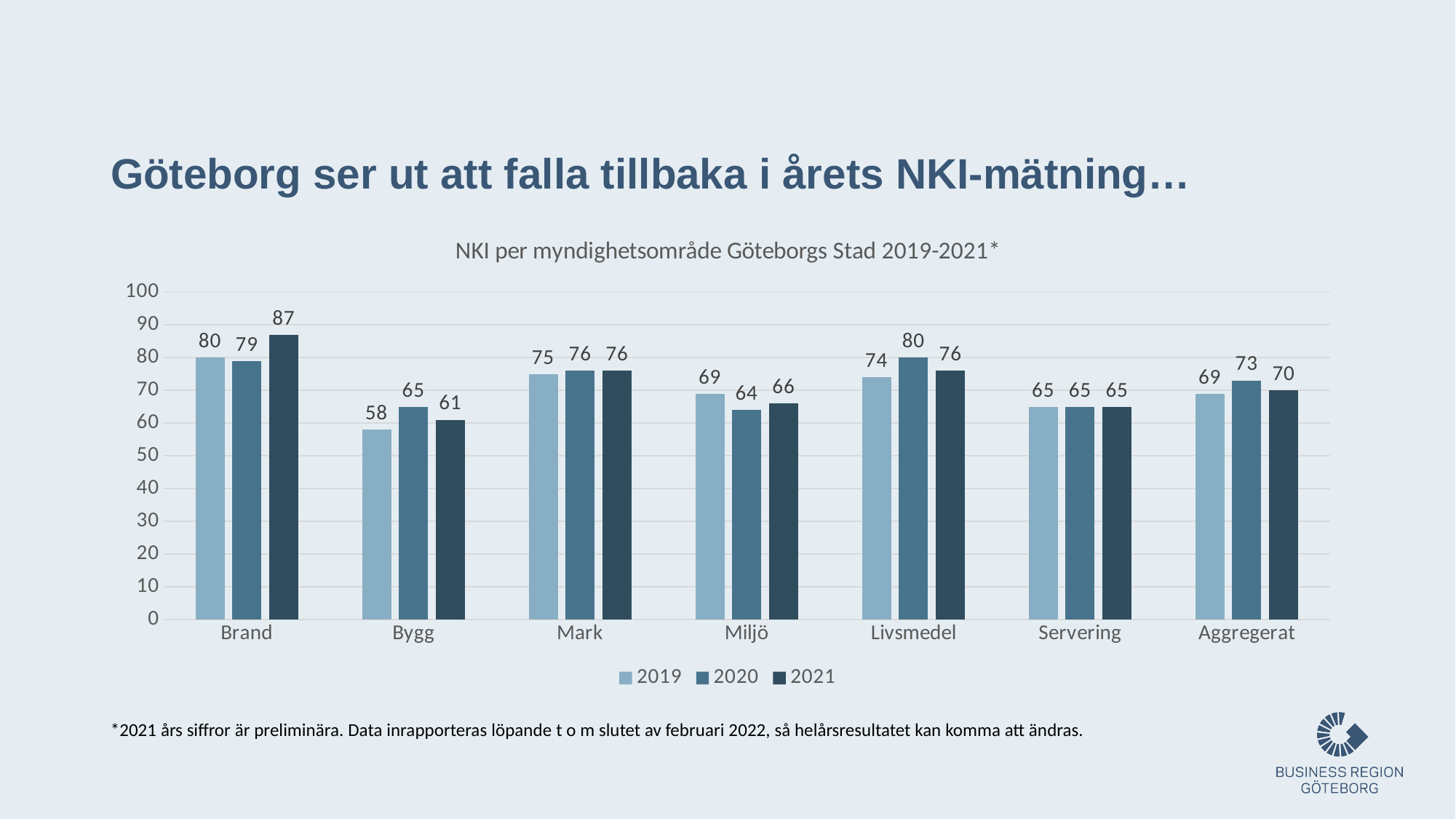
Which category has the lowest NKI value in 2019? Bygg What kind of chart is shown on the slide? Bar chart What is the difference between the 2021 and 2020 NKI values for Livsmedel? 4 What is the title of the chart? NKI per myndighetsområde Göteborgs Stad 2019-2021* What is the NKI value for Brand in 2021? 87 What is the NKI value for Aggregerat in 2020? 73 Which category has the highest NKI value in 2021? Brand Which is larger, the 2019 value for Miljö or the 2019 value for Mark? Mark How many series does the legend list? 3 Do the NKI values for Bygg rise or fall from 2020 to 2021? Fall What is the NKI value for Bygg in 2019? 58 How many categories are shown on the x axis? 7